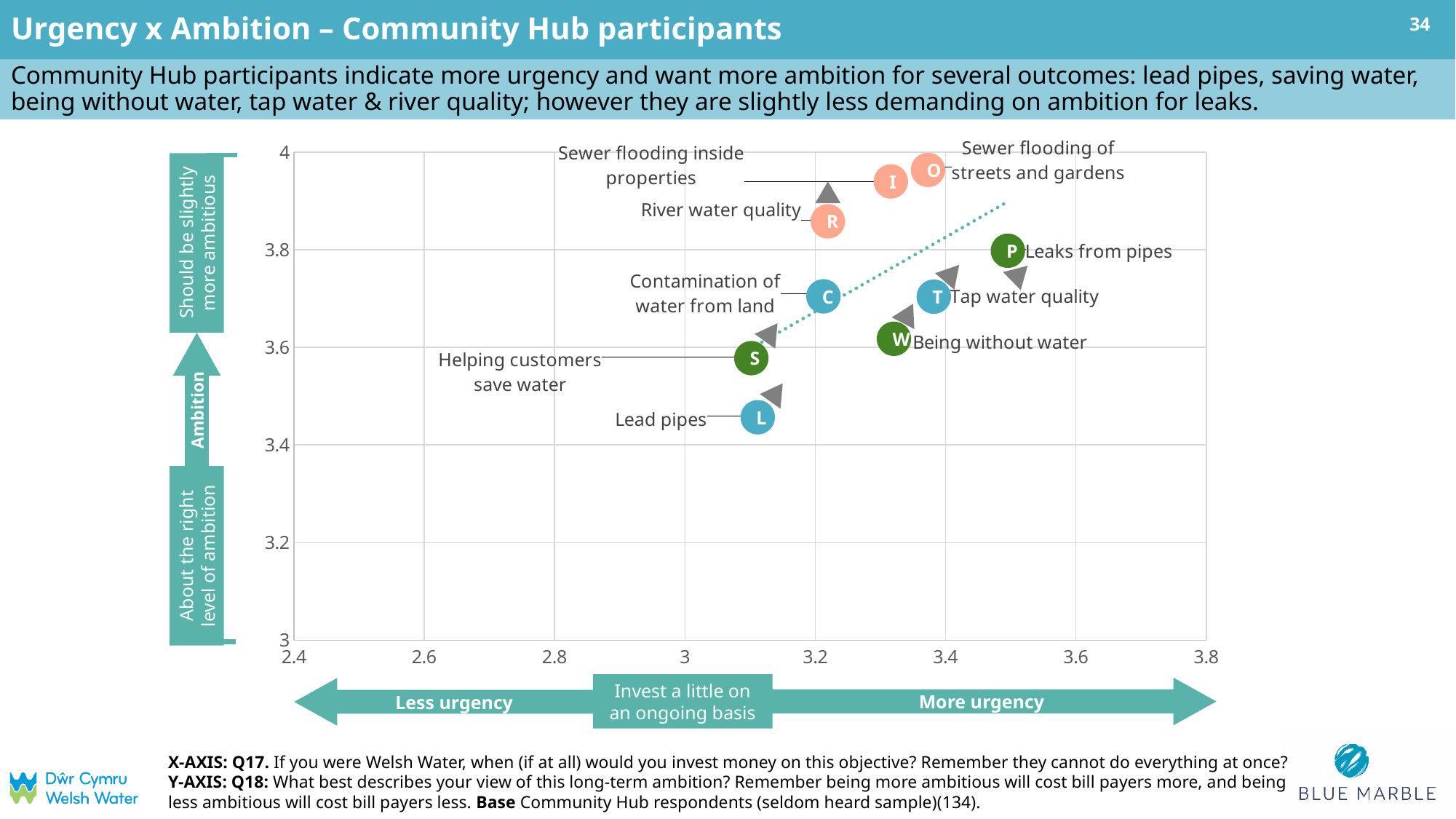
Which has the higher urgency score: Tap water quality or Contamination of water from land? Tap water quality Which outcome has the highest urgency score (x-axis) on the chart? Leaks from pipes What is the title of the chart slide? Urgency x Ambition – Community Hub participants Which has the higher ambition score: Leaks from pipes or Being without water? Leaks from pipes Which outcome has the lowest ambition score (y-axis) on the chart? Lead pipes Is the urgency score for Helping customers save water greater or less than 3? greater What kind of chart is shown on the slide? Scatter chart Is the urgency score for Leaks from pipes greater or less than 3.4? greater Is the ambition score for River water quality greater or less than 3.8? greater How many outcomes are plotted as points on the chart? 9 Which outcome has the highest ambition score (y-axis) on the chart? Sewer flooding of streets and gardens